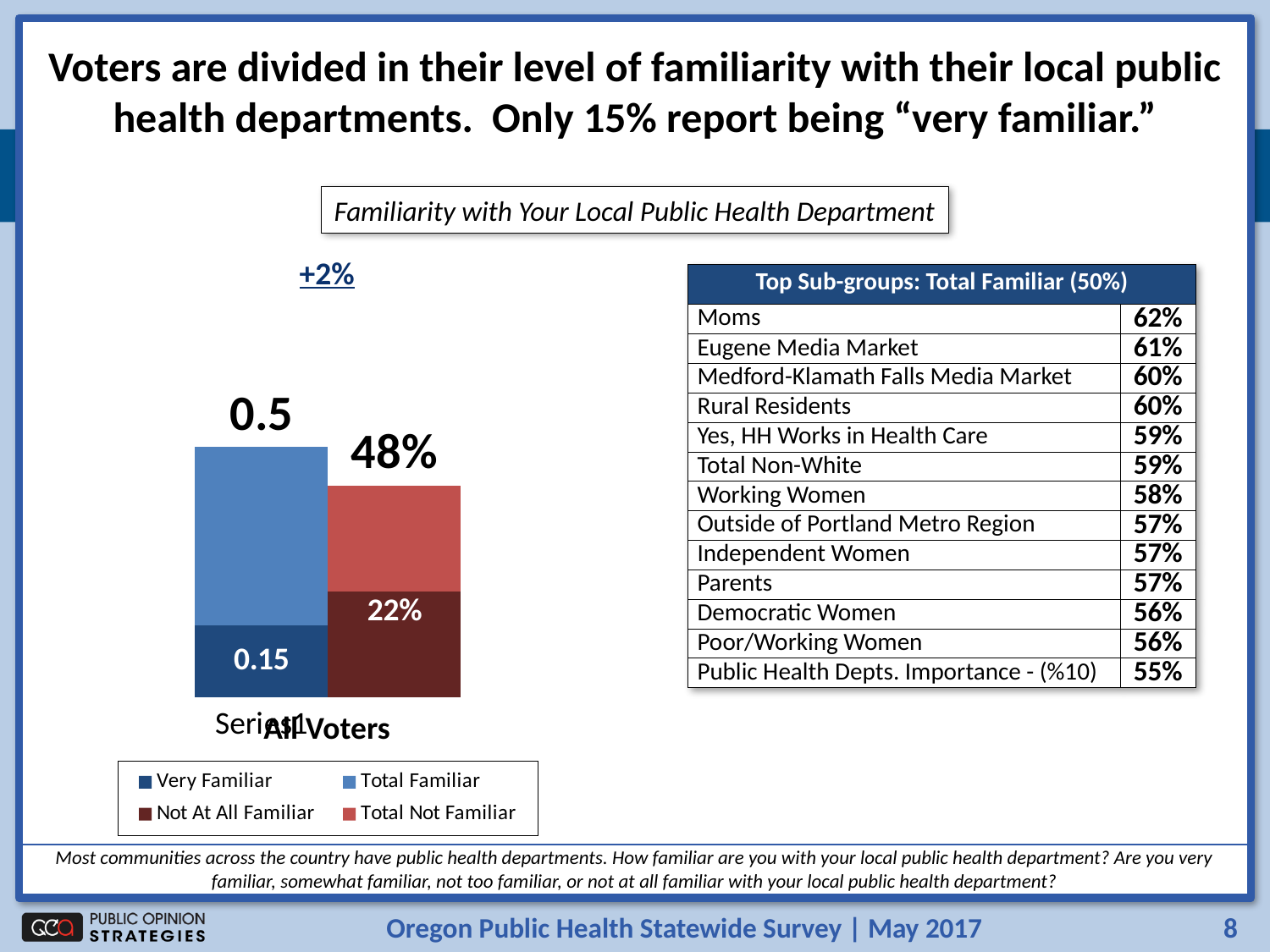
What is the title of the chart? Familiarity with Your Local Public Health Department What is the difference between Total Not Familiar (48%) and Not At All Familiar (22%)? 26% What annotation is printed above the bar chart? +2% What kind of chart is shown on the slide? bar chart How many categories are shown on the x axis of the bar chart? 1 What is the value shown for Very Familiar in the bar chart? 0.15 What is the value shown for Total Familiar in the bar chart? 0.5 Which is larger, Total Not Familiar or Not At All Familiar? Total Not Familiar Which legend series has the lowest value in the chart? Very Familiar What is the value shown for Total Not Familiar in the bar chart? 48% What is the value shown for Not At All Familiar in the bar chart? 22% How many series does the chart legend list? 4